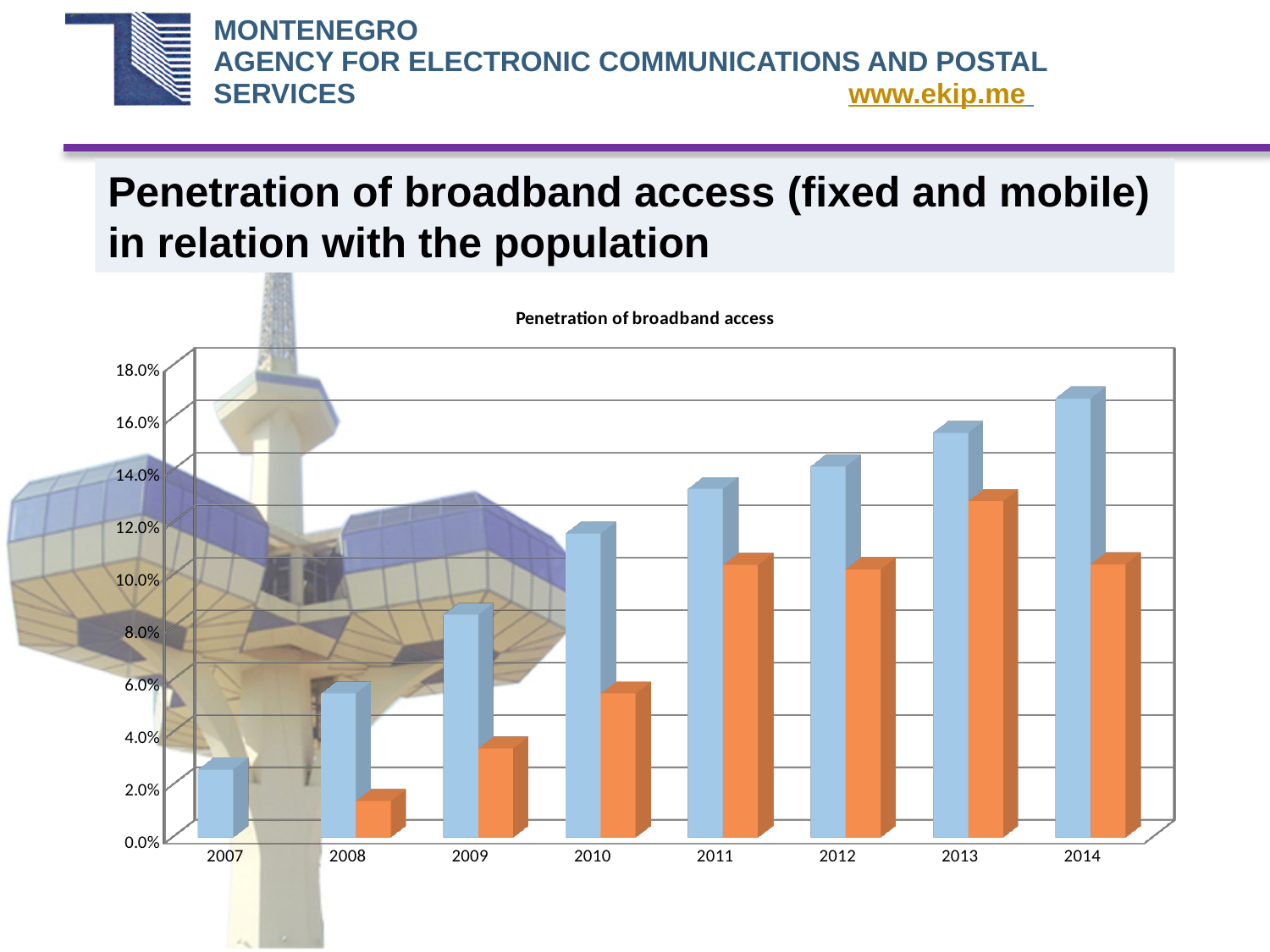
In which year is the blue bar lowest? 2007 How many years are shown on the x axis of the chart? 8 Is the orange bar for 2008 greater or less than 2.0%? less Is the blue bar for 2007 greater or less than 4.0%? less In 2014, which bar is larger, the blue bar or the orange bar? The blue bar Is the blue bar for 2010 greater or less than 10.0%? greater What is the title of the chart? Penetration of broadband access What kind of chart is shown on the slide? Bar chart Do the blue bars rise or fall from 2007 to 2014? Rise In which year is the blue bar highest? 2014 In which year is the orange bar highest? 2013